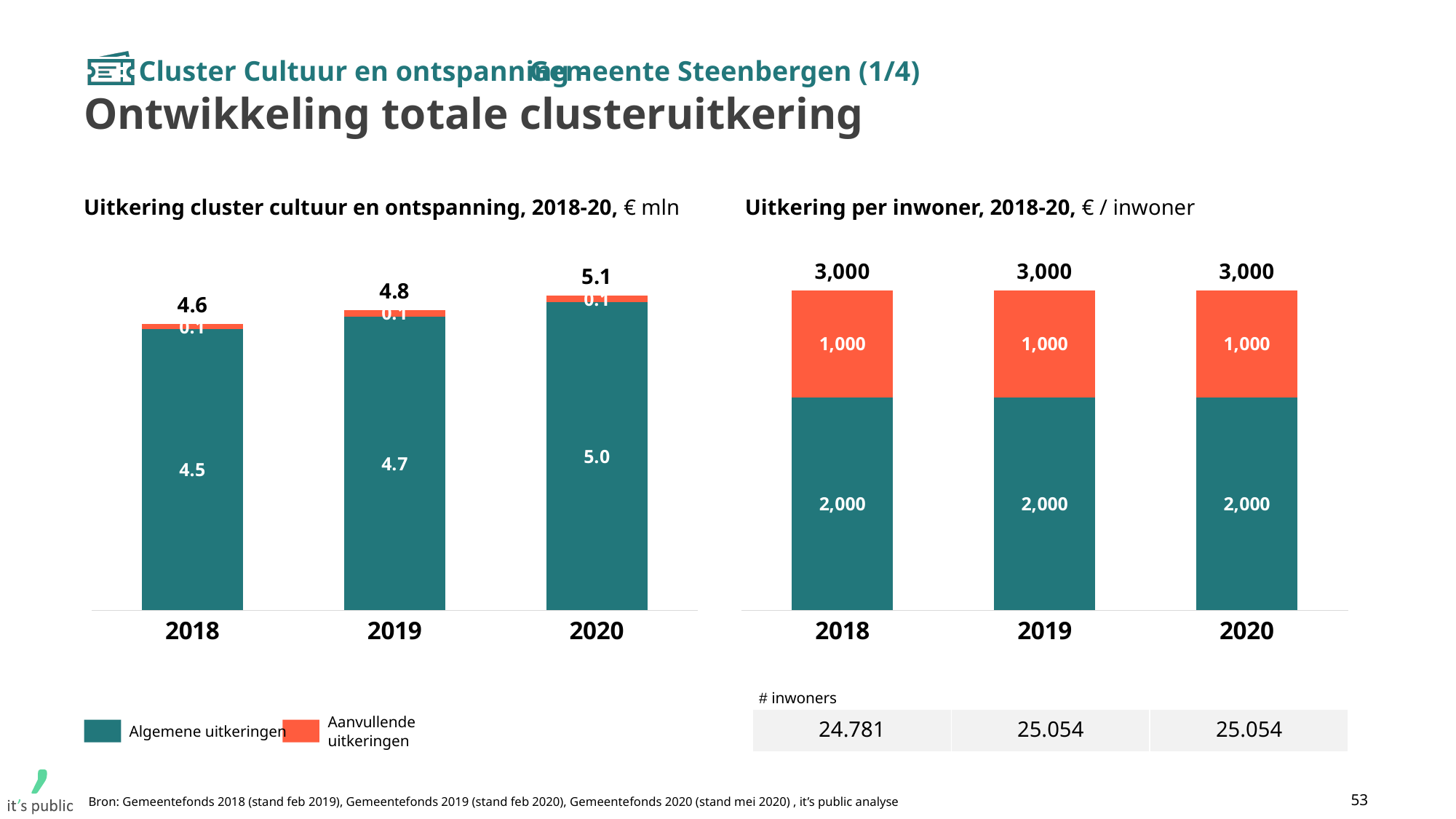
In the left chart (Uitkering cluster cultuur en ontspanning), do the total values rise or fall from 2018 to 2020? rise In the right chart (Uitkering per inwoner), what is the value of Aanvullende uitkeringen for 2019? 1,000 In the left chart (Uitkering cluster cultuur en ontspanning), what is the value of Aanvullende uitkeringen for 2018? 0.1 How many years are shown on the x axis of the left chart (Uitkering cluster cultuur en ontspanning)? 3 How many series does the legend list for the charts on the slide? 2 In the left chart (Uitkering cluster cultuur en ontspanning), what is the difference between the Algemene uitkeringen for 2020 and 2018? 0.5 In the left chart (Uitkering cluster cultuur en ontspanning), what is the total of the stacked bar for 2019? 4.8 What kind of chart is the right chart (Uitkering per inwoner)? stacked bar chart In the right chart (Uitkering per inwoner), what is the total of the stacked bar for 2020? 3,000 In the right chart (Uitkering per inwoner), which is larger for 2018: Algemene uitkeringen or Aanvullende uitkeringen? Algemene uitkeringen In the left chart (Uitkering cluster cultuur en ontspanning), which year has the highest total uitkering? 2020 In the left chart (Uitkering cluster cultuur en ontspanning), what is the value of Algemene uitkeringen for 2020? 5.0